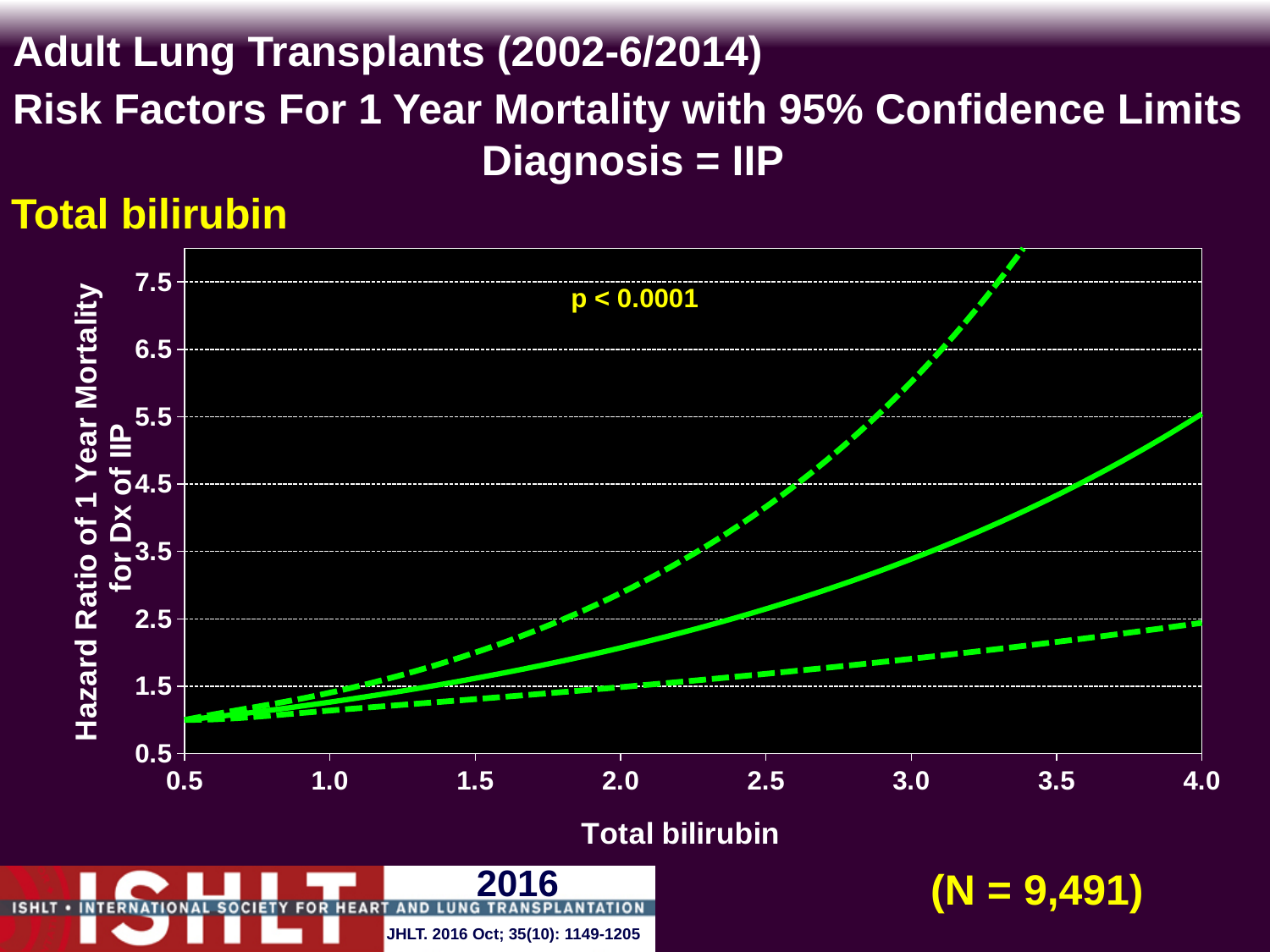
How many lines are plotted on the chart? 3 Does the solid hazard ratio line rise or fall as total bilirubin increases from 0.5 to 4.0? rise Is the value of the upper dashed confidence limit at a total bilirubin of 3.5 greater or less than 7.5? greater What sample size (N) is shown on the slide? N = 9,491 Is the value of the solid hazard ratio line at a total bilirubin of 2.0 greater or less than 2.5? less Is the value of the solid hazard ratio line at a total bilirubin of 3.0 greater or less than 2.5? greater What p-value is printed on the chart? p < 0.0001 What kind of chart is shown on the slide? line chart At a total bilirubin of 3.0, which is larger: the upper dashed confidence limit or the solid hazard ratio line? the upper dashed confidence limit